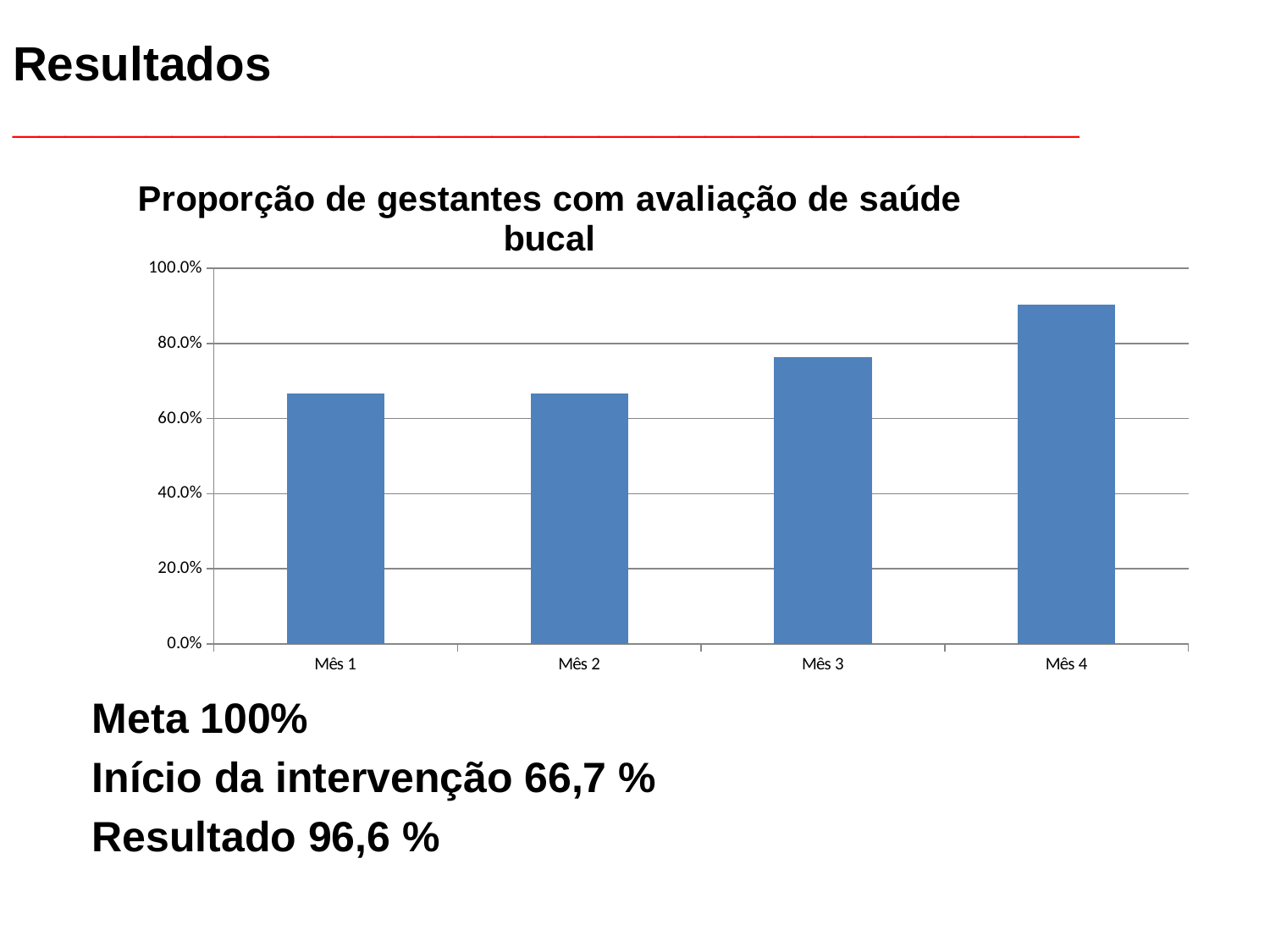
Is the value for Mês 4 greater or less than 80.0%? greater How many months (categories) are plotted on the x axis? 4 Do the values rise or fall from Mês 1 to Mês 4? rise Is the value for Mês 1 greater or less than 60.0%? greater What is the title of the chart? Proporção de gestantes com avaliação de saúde bucal Which month has the highest value? Mês 4 Which is larger, the value for Mês 1 or the value for Mês 3? Mês 3 Is the value for Mês 3 greater or less than 80.0%? less Which is larger, the value for Mês 3 or the value for Mês 4? Mês 4 What kind of chart is shown on the slide? bar chart